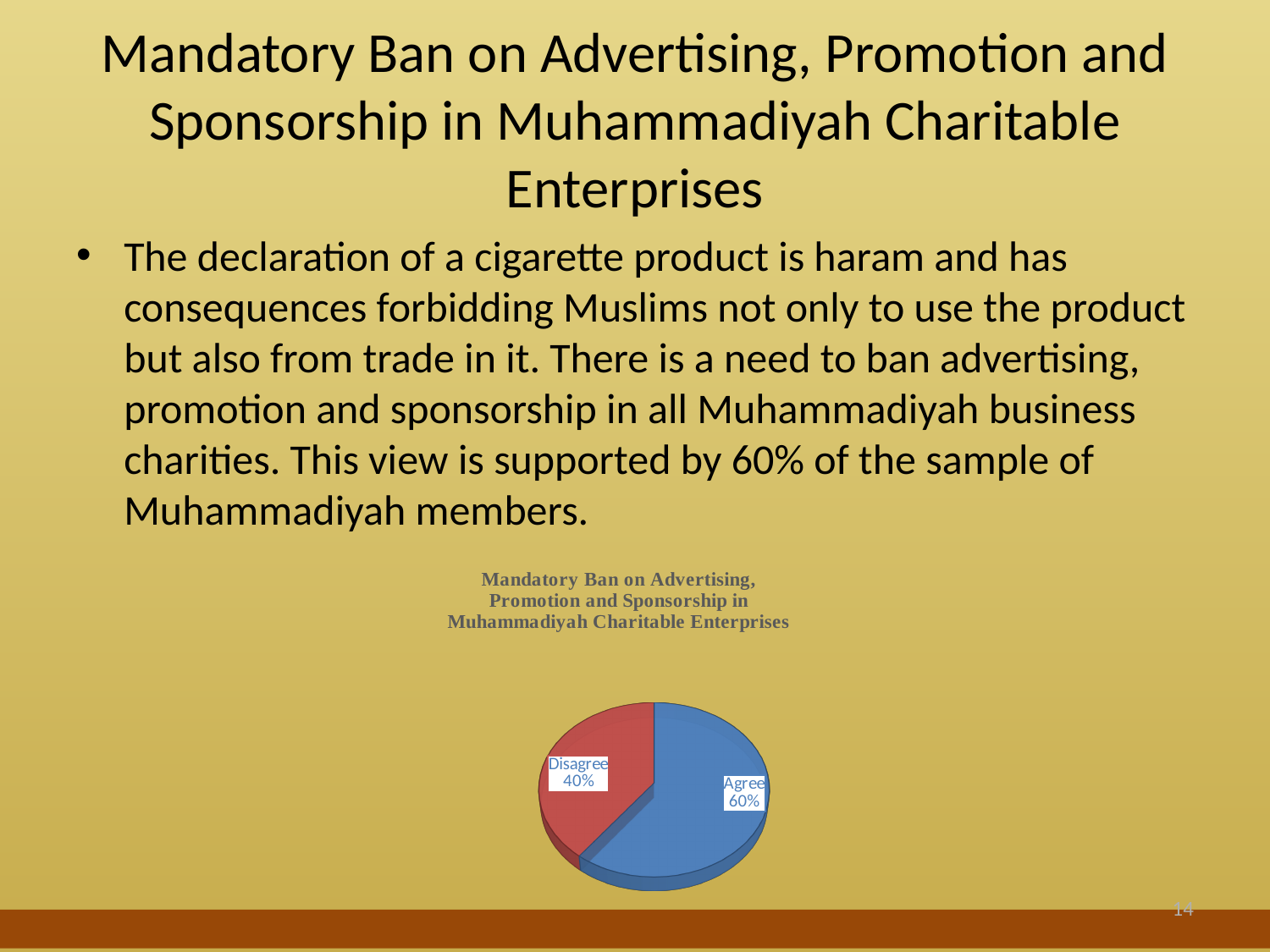
What is the difference in percentage points between the Agree and Disagree slices? 20 What share of the pie does the Disagree slice take? 40% What kind of chart is shown on the slide? pie chart Which slice of the pie is the largest? Agree What percentage of the pie is labelled Agree? 60% Which is larger, the Agree slice or the Disagree slice? Agree Which slice of the pie is the smallest? Disagree What percentage of the pie is labelled Disagree? 40% How many slices does the pie chart have? 2 What is the title of the pie chart? Mandatory Ban on Advertising, Promotion and Sponsorship in Muhammadiyah Charitable Enterprises What colour is the Agree slice of the pie chart? blue